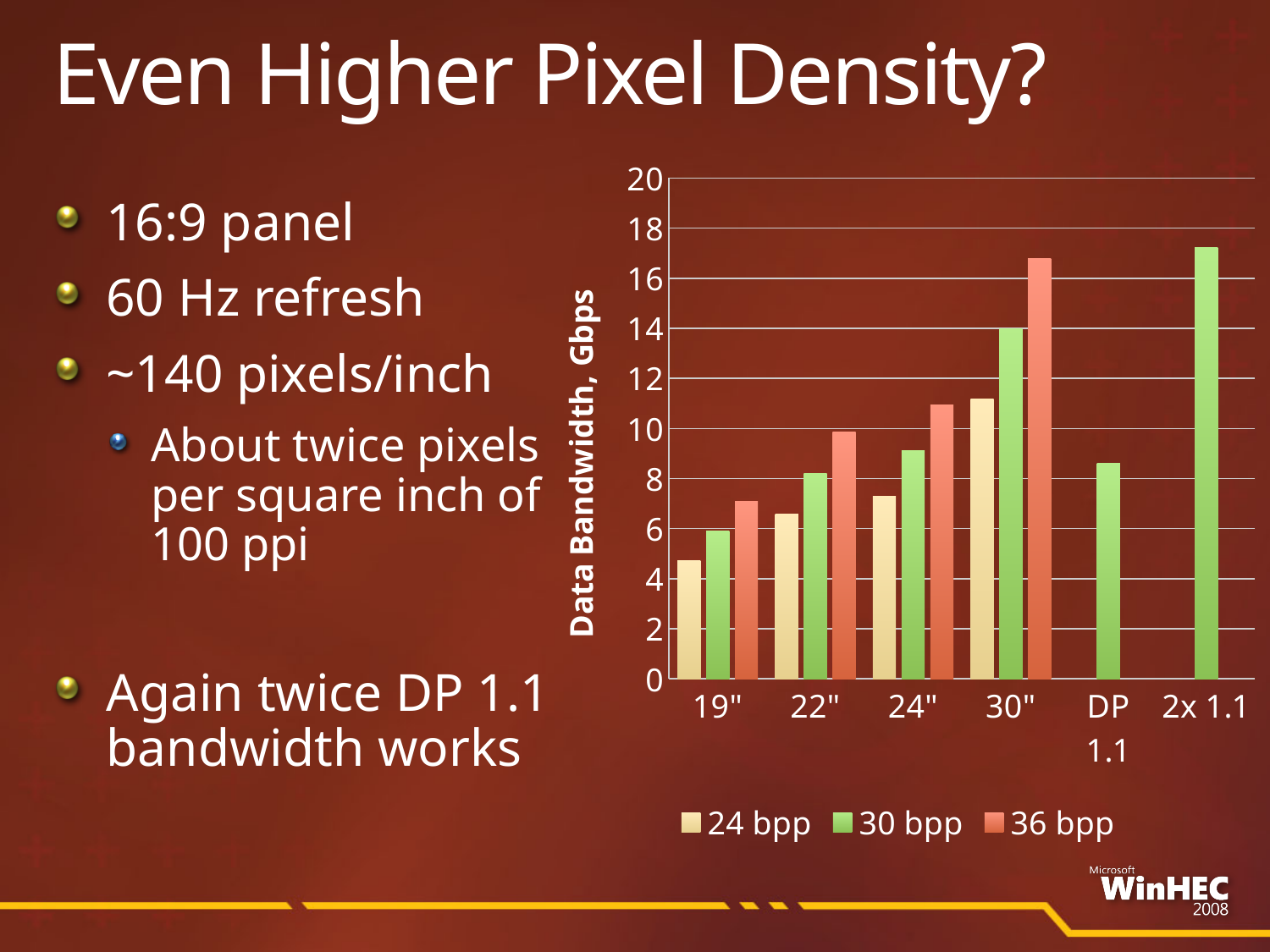
What is the title of the chart's vertical axis? Data Bandwidth, Gbps Which category has the lowest 24 bpp value? 19" What kind of chart is shown on the slide? bar chart Among the panel sizes 19", 22", 24" and 30", which has the highest 36 bpp value? 30" How many categories are shown along the x axis of the chart? 6 Which is larger: the 30 bpp value for 30" or the 30 bpp value for 2x 1.1? 2x 1.1 Is the 30 bpp value for DP 1.1 greater or less than 10? less Which series in the chart is drawn in green? 30 bpp How many series does the chart's legend list? 3 Is the 30 bpp value for 2x 1.1 greater or less than 16? greater Is the 24 bpp value for 19" greater or less than 6? less